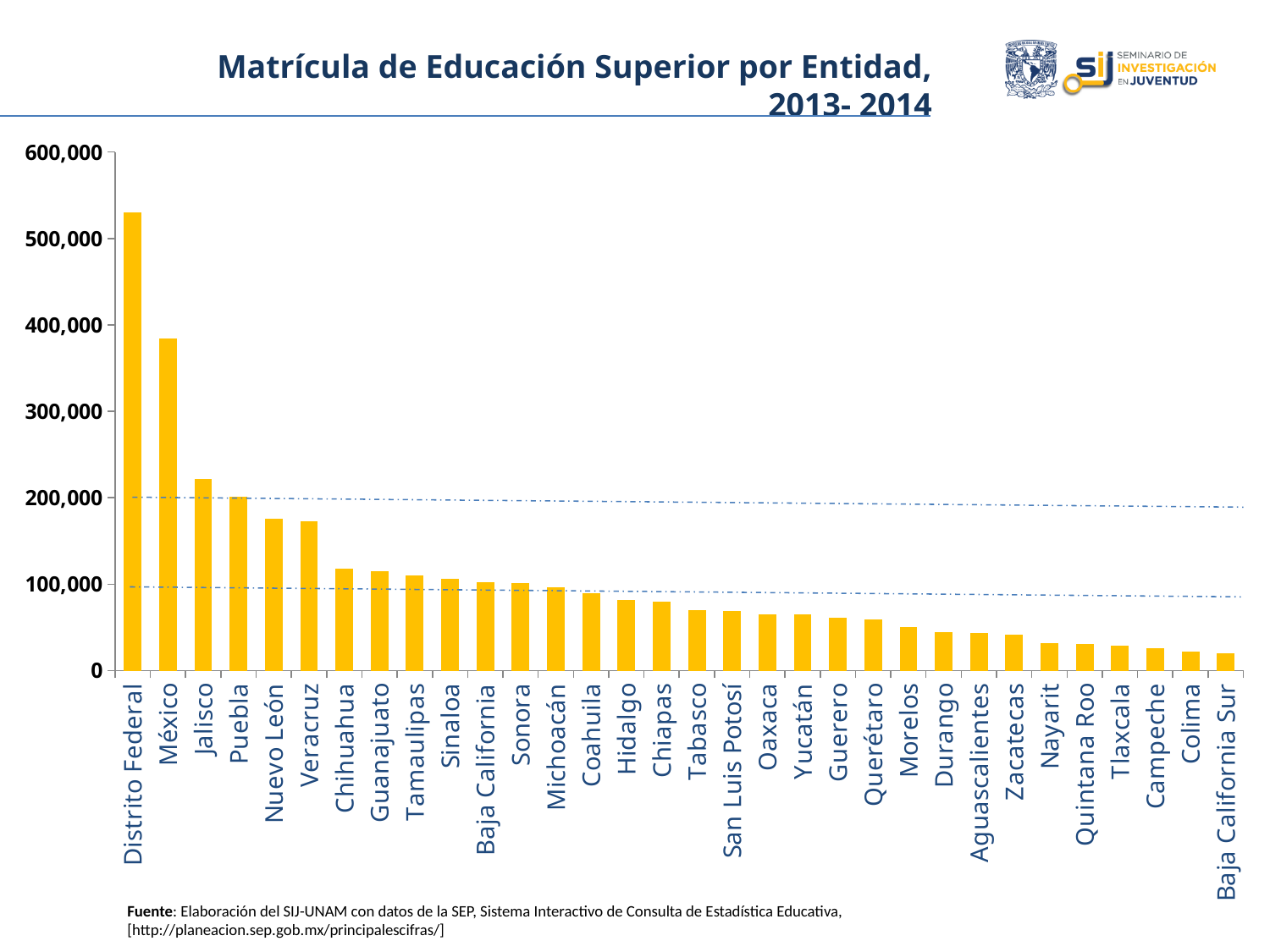
Is the value for Nuevo León greater or less than 200,000? less Is the value for Chihuahua greater or less than 100,000? greater What kind of chart is shown on the slide? bar chart Is the value for Jalisco greater or less than 200,000? greater Do the values rise or fall moving from left to right along the x axis? fall Which entity has the highest higher-education enrolment in the chart? Distrito Federal Which entity has the lowest higher-education enrolment in the chart? Baja California Sur Which has a larger value, Jalisco or Veracruz? Jalisco How many entities (bars) are shown in the chart? 32 Which has a larger value, Oaxaca or Morelos? Oaxaca